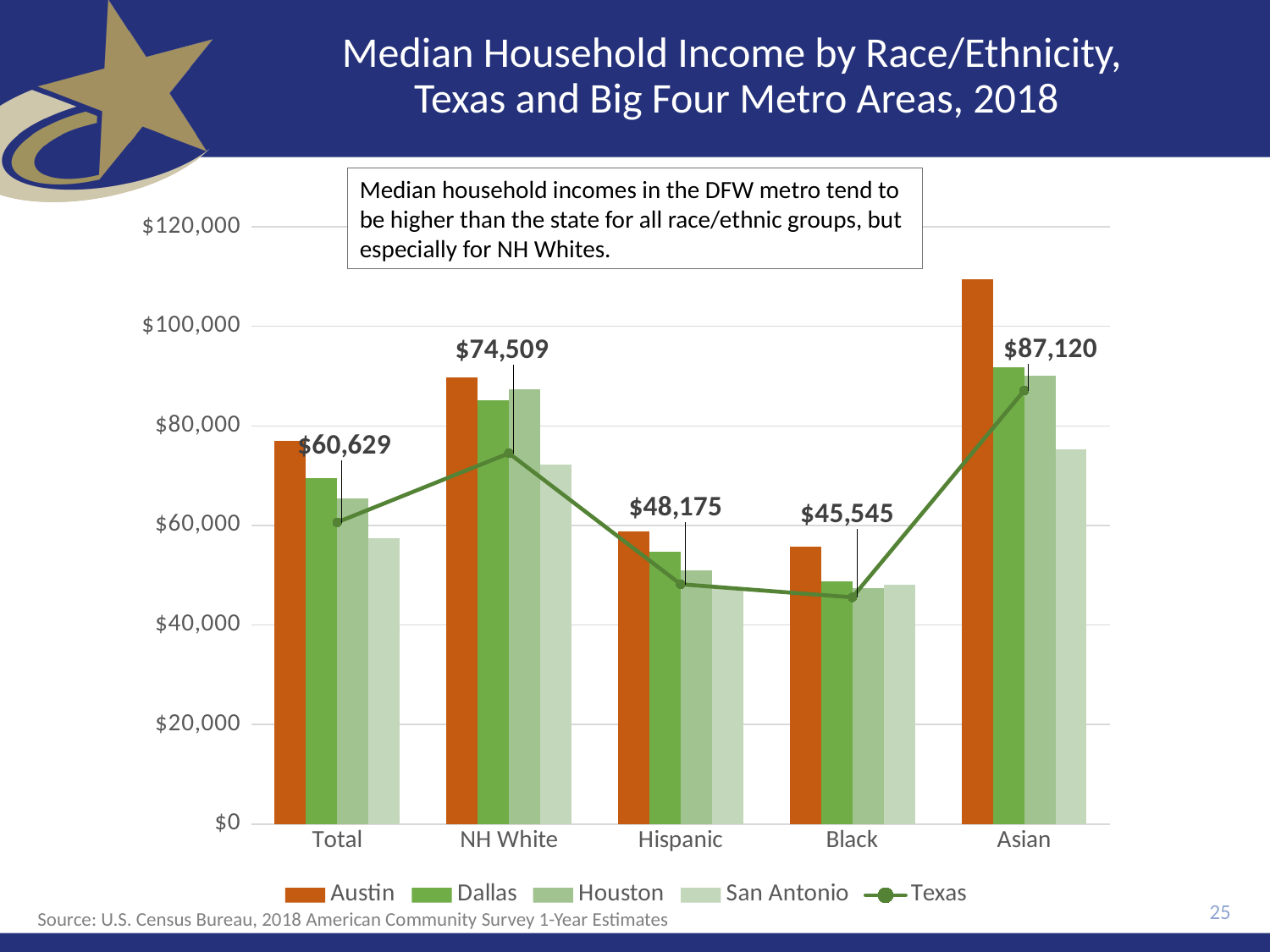
How many series does the legend list? 5 Which race/ethnicity category has the lowest Texas median household income? Black Is the San Antonio median household income for Black households greater or less than $60,000? less Which is larger, the Texas median household income for Hispanic households or for Black households? Hispanic What is the Texas median household income for the Total category? $60,629 How many race/ethnicity categories are shown on the x axis? 5 Is the Austin median household income for Asian households greater or less than $100,000? greater Does the Texas line rise or fall from Black to Asian? rises How much higher is the Texas median household income for Asian households than for the Total category? $26,491 What is the Texas median household income for NH White households? $74,509 Which race/ethnicity category has the highest Texas median household income? Asian What is the Texas median household income for Black households? $45,545